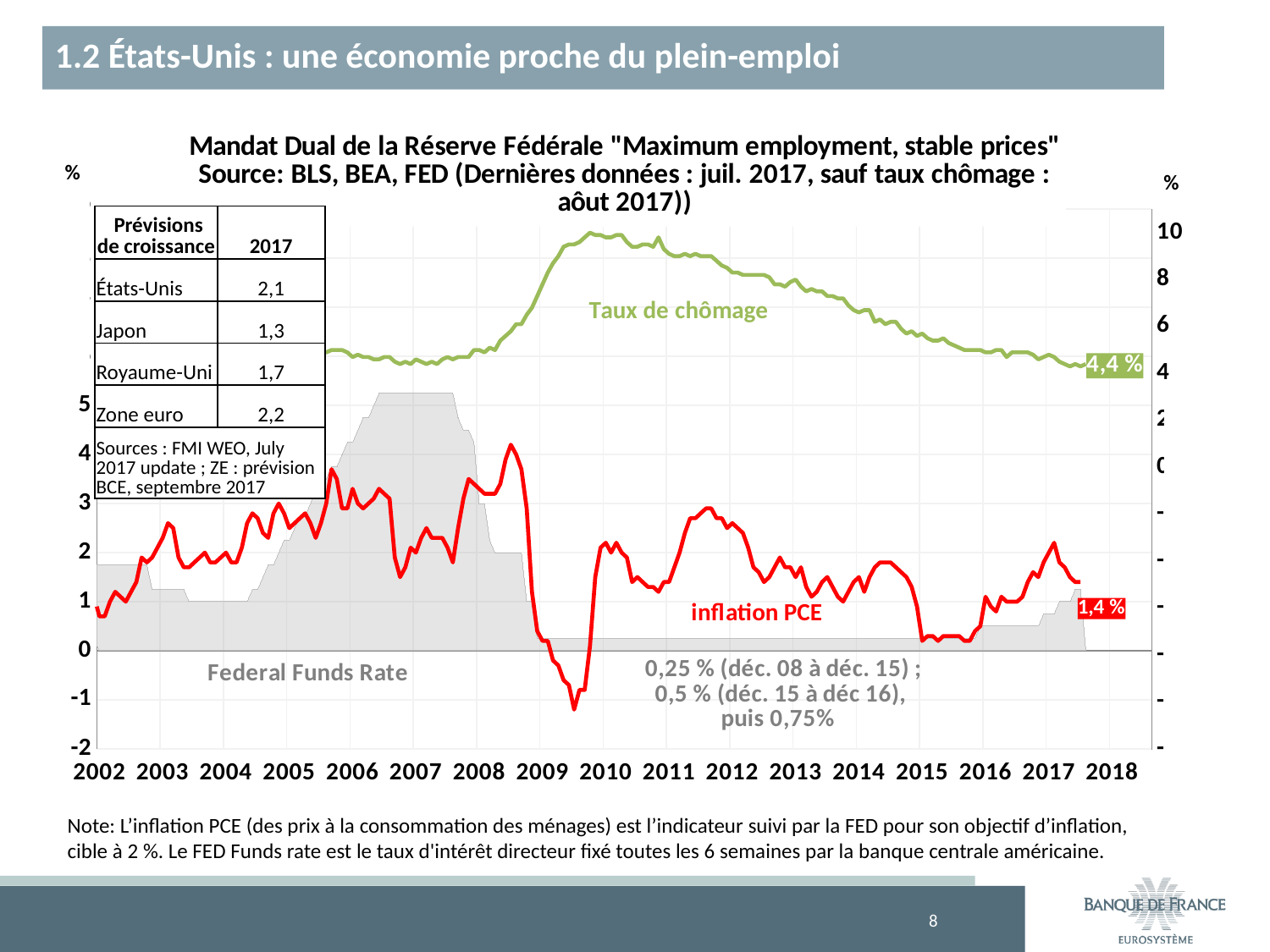
Is the lowest point of the inflation PCE series in 2009 greater or less than 0? less Is the peak of the Federal Funds Rate around 2007 greater or less than 4 on the left axis? greater What colour is the Taux de chômage line? green What is the latest value shown for the inflation PCE series? 1,4 % According to the annotation, what was the Federal Funds Rate from December 2015 to December 2016? 0,5 % What kind of chart is shown on the slide? combination area and line chart Is the peak of the Taux de chômage series around 2010 greater or less than 8 on the right axis? greater According to the annotation, what was the Federal Funds Rate from December 2008 to December 2015? 0,25 % How many data series are plotted on the chart? 3 Does the Taux de chômage series rise or fall between 2010 and 2017? fall Does the Taux de chômage series rise or fall between 2007 and 2010? rise What is the latest value shown for the Taux de chômage series? 4,4 %